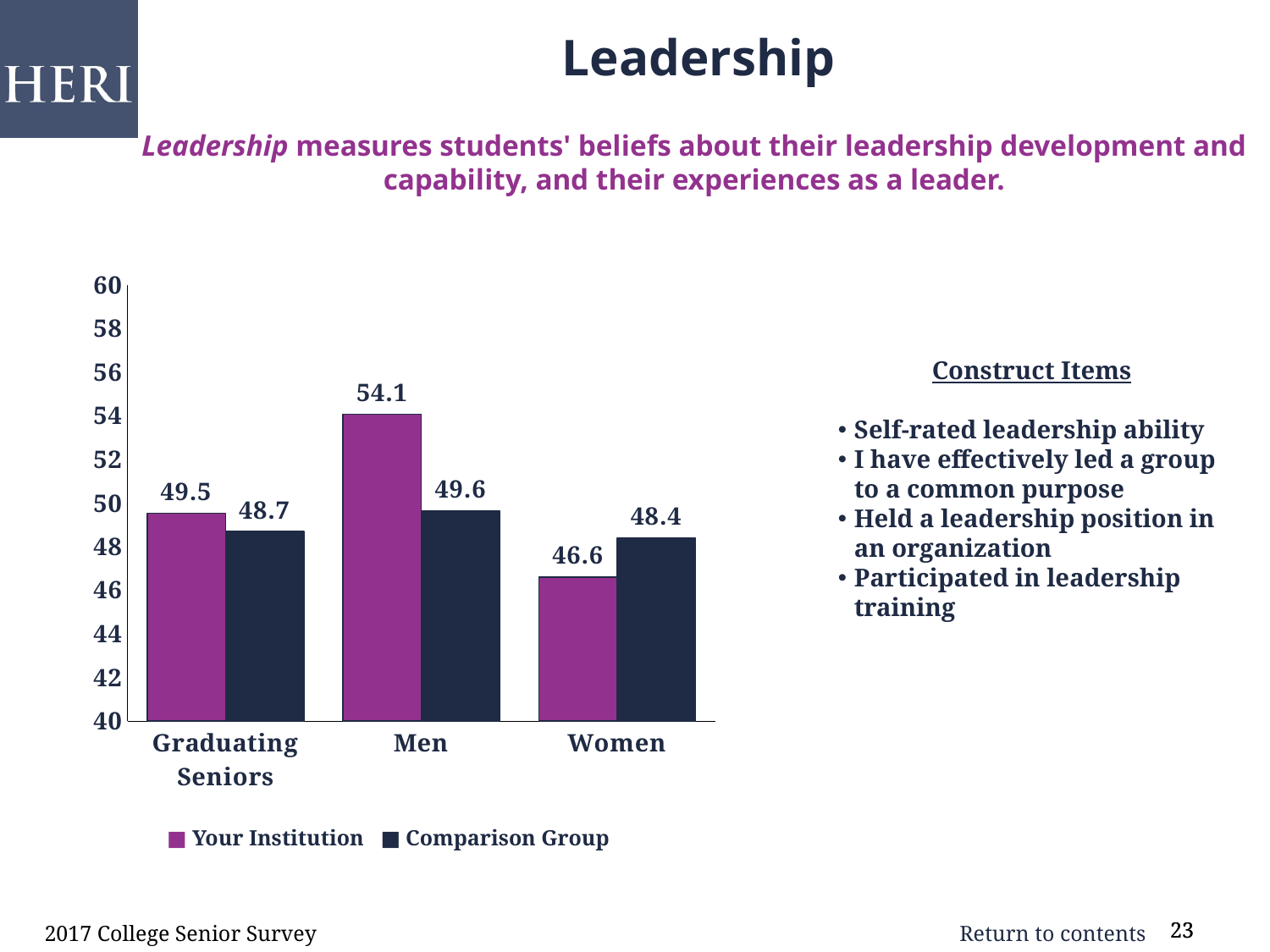
What is the Your Institution value for Men? 54.1 What kind of chart is shown on the slide? bar chart What is the difference between the Your Institution and Comparison Group values for Men? 4.5 What is the Your Institution value for Graduating Seniors? 49.5 Which category has the highest Your Institution value? Men How many series does the legend list? 2 Which category has the lowest Your Institution value? Women For Women, which is larger: Your Institution or Comparison Group? Comparison Group What is the Comparison Group value for Women? 48.4 Is the Your Institution value for Men greater or less than 52? greater How many categories are shown on the x axis? 3 What is the difference between the Comparison Group and Your Institution values for Women? 1.8